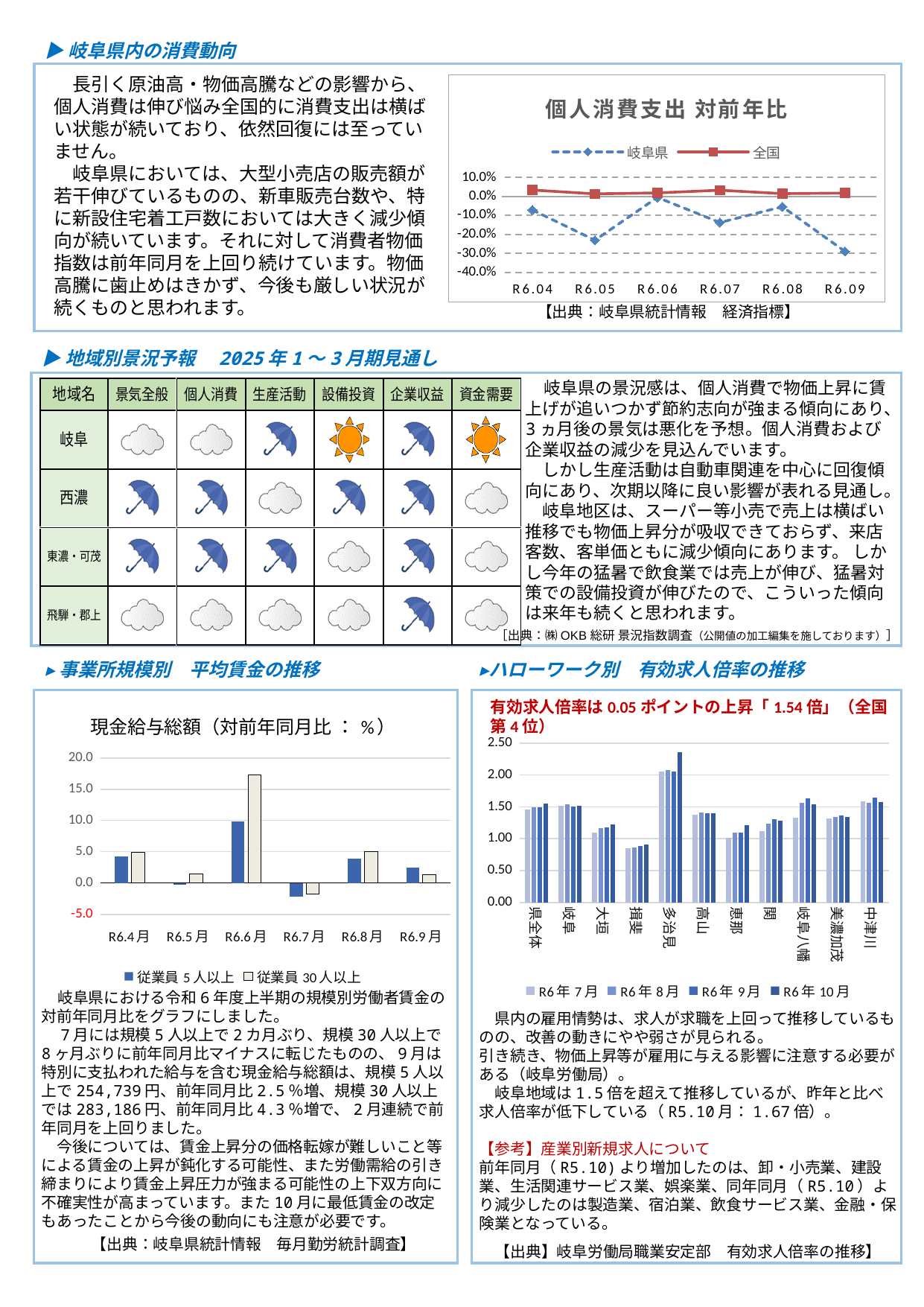
In the 個人消費支出 対前年比 chart, which series has the larger value at R6.05, 岐阜県 or 全国? 全国 In the 現金給与総額 chart, which month has the highest value for 従業員30人以上? R6.6月 In the 有効求人倍率 chart (bottom right), which Hello Work area has the highest values? 多治見 How many periods are plotted on the x axis of the 個人消費支出 対前年比 chart? 6 How many series does the legend of the 個人消費支出 対前年比 chart list? 2 How many series does the legend of the 有効求人倍率 chart (bottom right) list? 4 In the 現金給与総額 chart, is the 従業員30人以上 value for R6.6月 greater or less than 15.0? greater What kind of chart is the 個人消費支出 対前年比 chart? line chart In the 有効求人倍率 chart (bottom right), is the R6年10月 value for 多治見 greater or less than 2.00? greater In the 個人消費支出 対前年比 chart, at which period is the 岐阜県 value lowest? R6.09 In the 現金給与総額 chart, is the 従業員5人以上 value for R6.7月 greater or less than 0.0? less